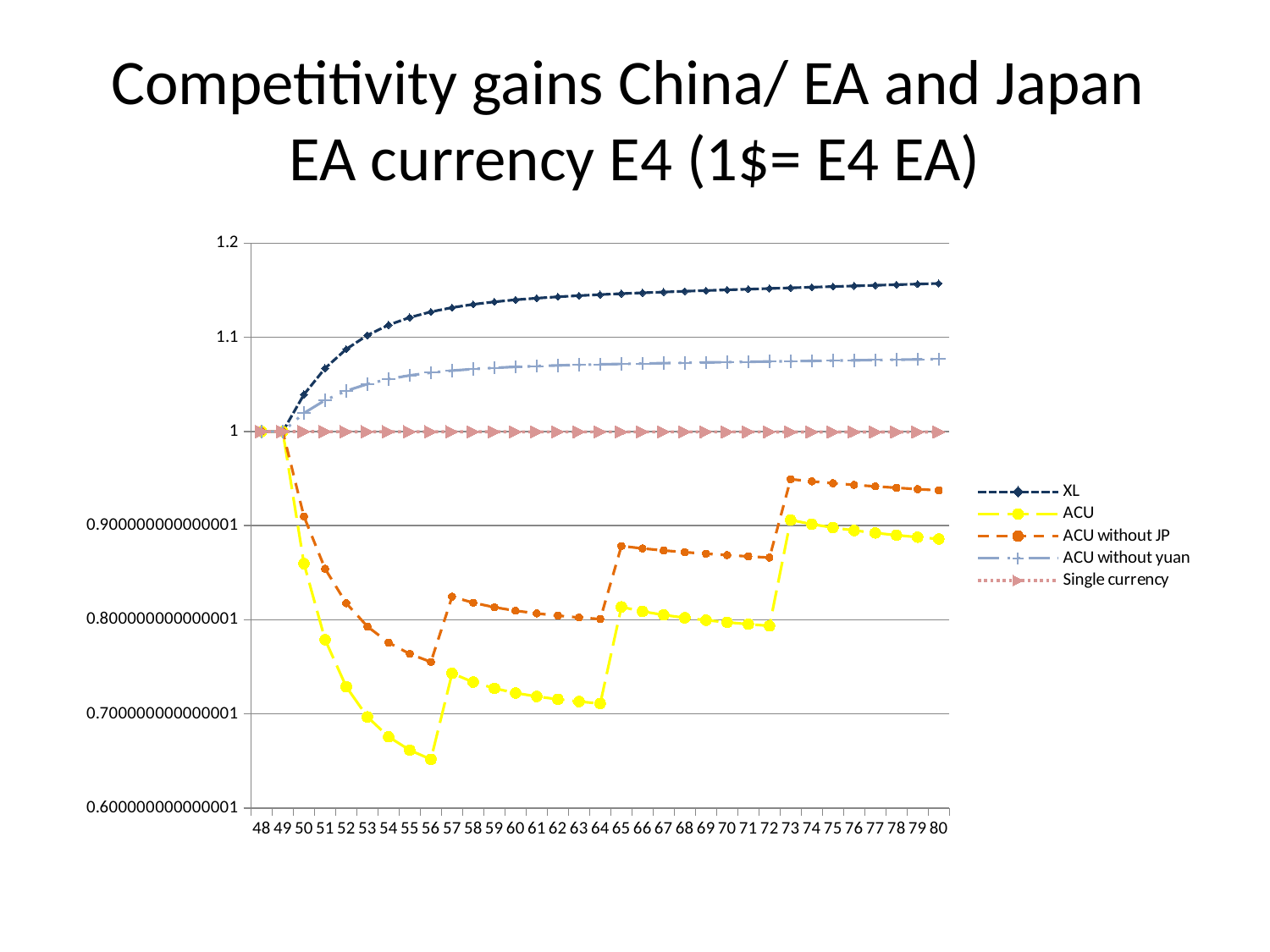
Which series has the highest value at x = 80? XL Is the value for ACU without JP at x = 56 greater or less than 0.8? less How many points are on the x axis (from 48 to 80)? 33 Is the value for XL at x = 80 greater or less than 1.1? greater Is the value for ACU at x = 56 greater or less than 0.7? less Which series has the lowest value at x = 56? ACU What is the value of the Single currency series at x = 60? 1 How many series does the legend list? 5 At x = 80, which is larger: XL or ACU without yuan? XL What kind of chart is shown on the slide? line chart Does the XL series rise or fall from x = 49 to x = 80? rise